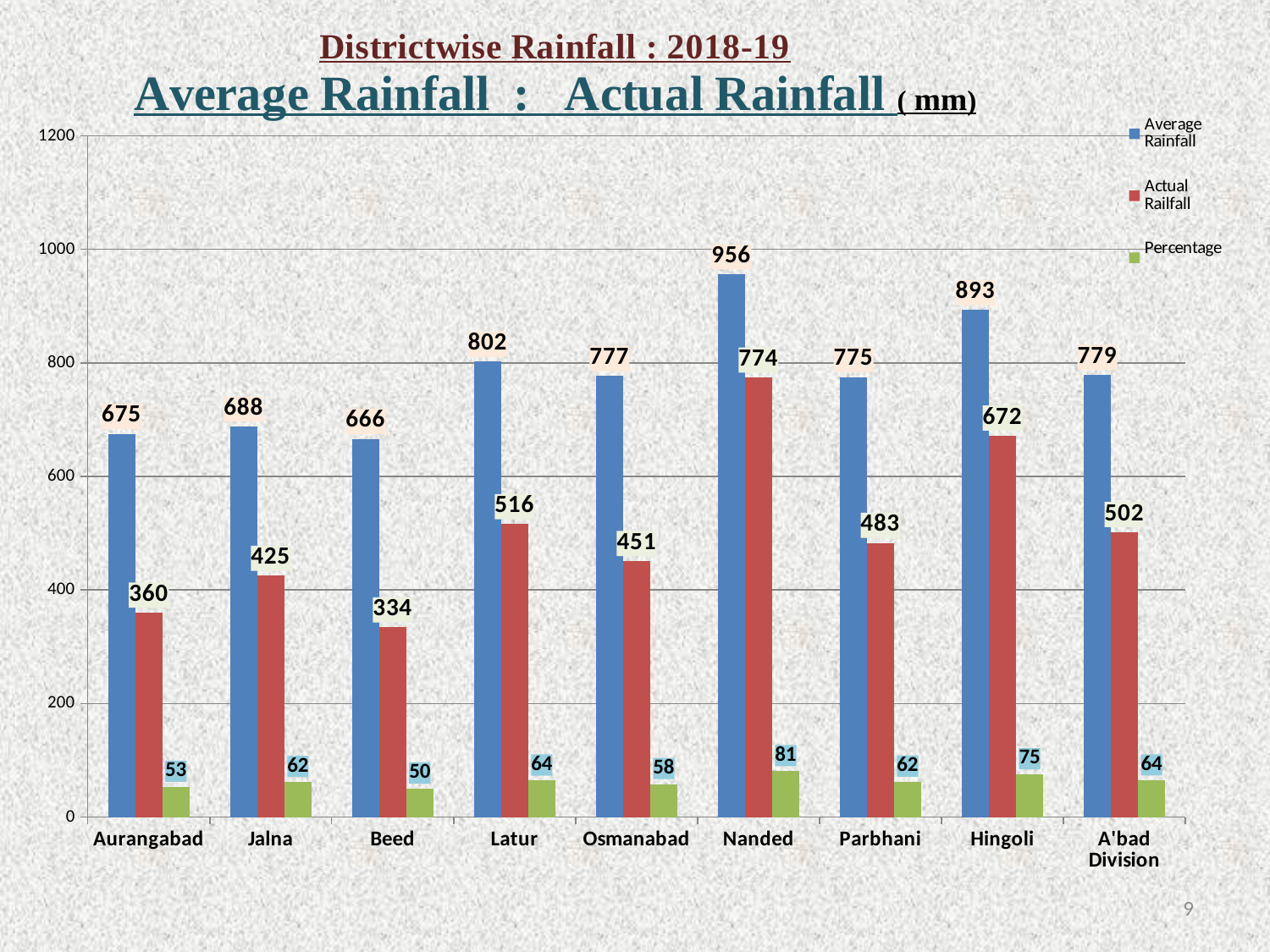
What is the Actual Rainfall value for Beed? 334 How many categories are shown on the x axis? 9 How many series does the legend list? 3 What is the difference between Average Rainfall and Actual Rainfall for Aurangabad? 315 Which category has the lowest Actual Rainfall? Beed What is the Average Rainfall value for Latur? 802 What kind of chart is shown on the slide? bar chart What is the Percentage value for Nanded? 81 Which district has the highest Average Rainfall? Nanded Which is larger, the Actual Rainfall for Hingoli or the Actual Rainfall for Parbhani? Hingoli Is the Average Rainfall for Hingoli greater or less than 800? greater Which colour represents the Percentage series in the legend? green